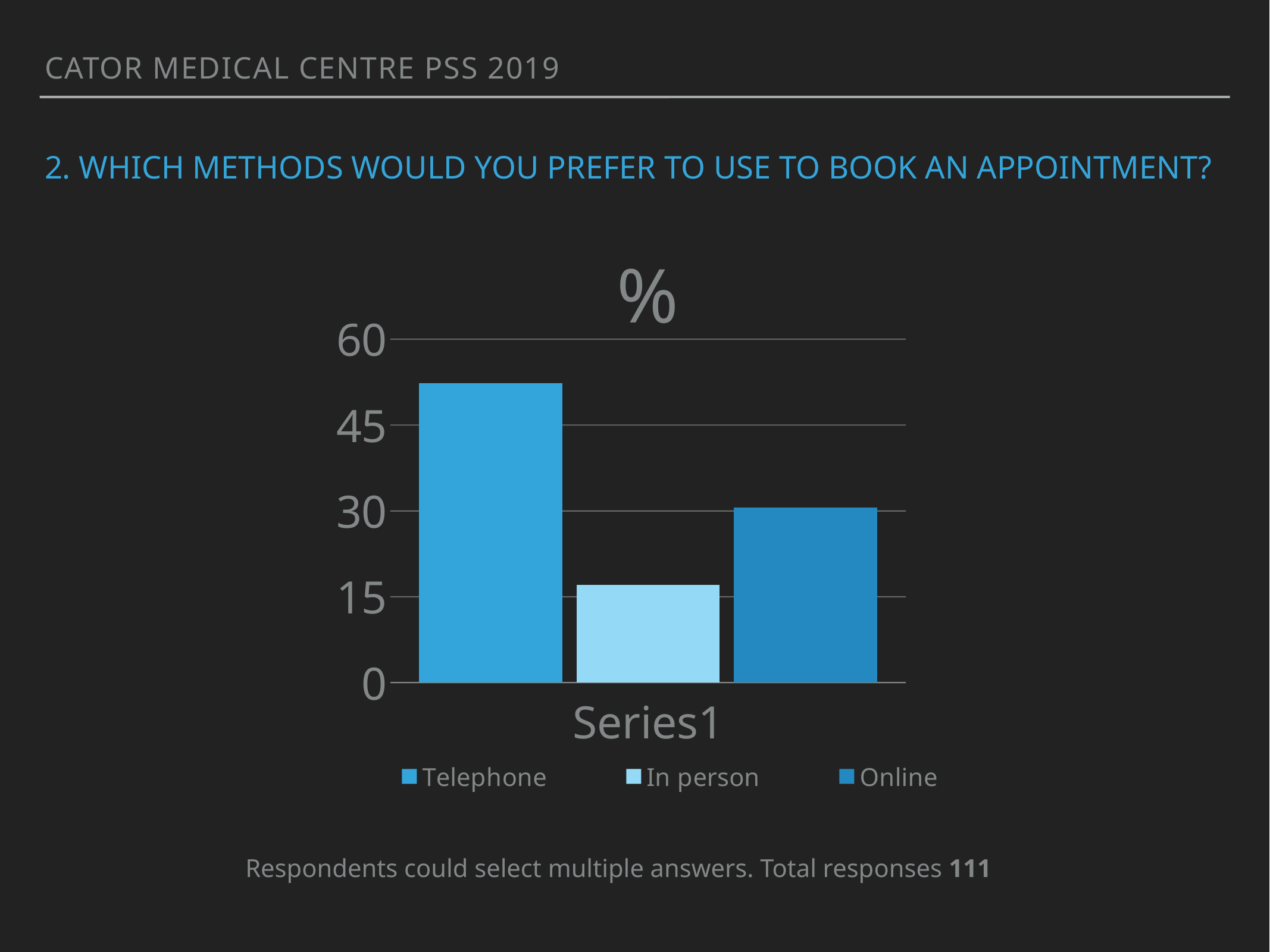
Is the value for Telephone greater or less than 45? greater Which is larger, the value for Online or the value for In person? Online Which is larger, the value for Telephone or the value for Online? Telephone How many series does the chart legend list? 3 What are the three legend entries of the chart? Telephone, In person, Online What kind of chart is shown on the slide? bar chart Which booking method has the lowest bar in the chart? In person What is the title of the chart? % Which booking method has the highest bar in the chart? Telephone Is the value for In person greater or less than 30? less Is the value for Telephone greater or less than 60? less